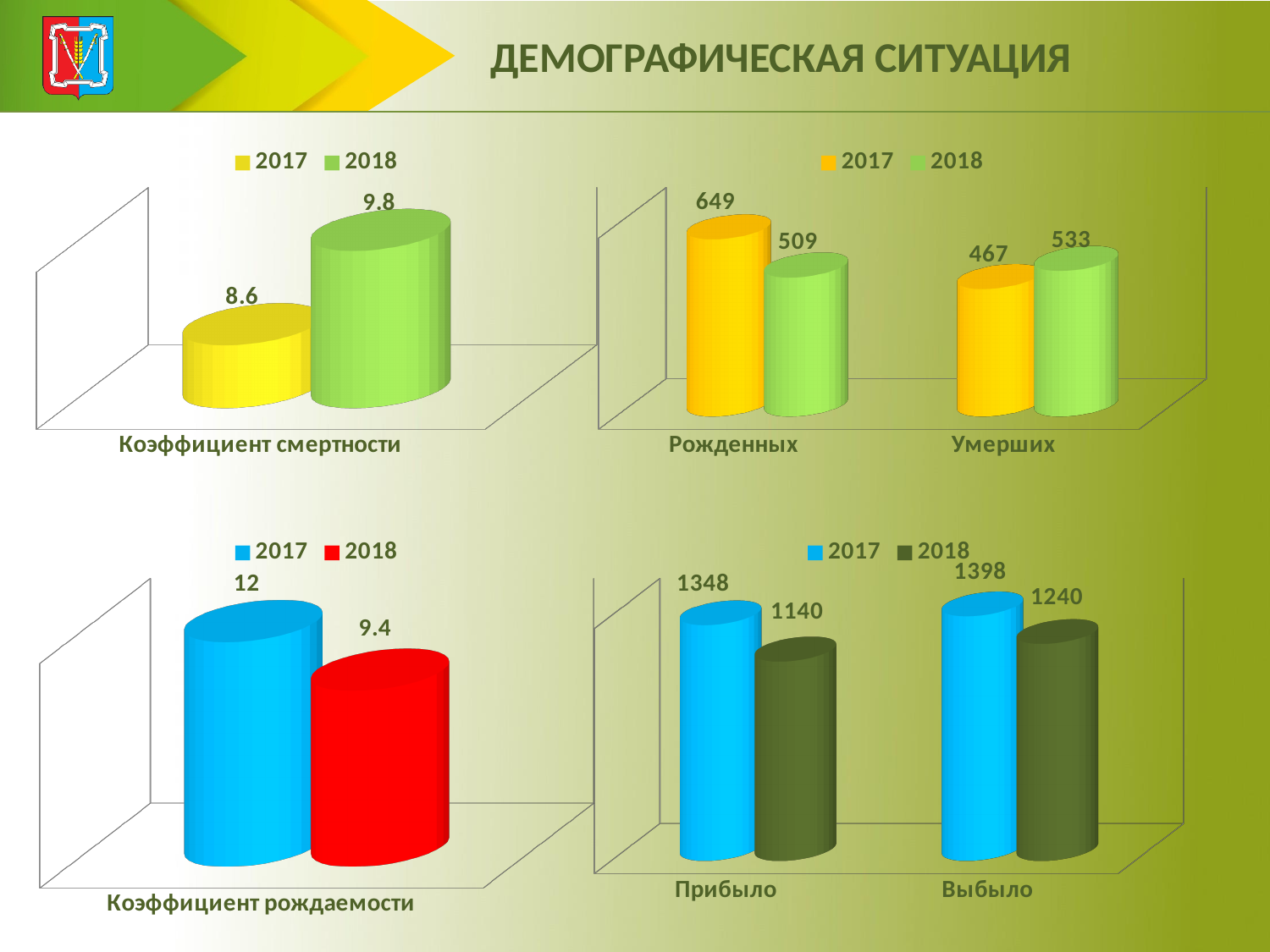
In the bottom-right chart, how many categories are shown on the x axis? 2 In the bottom-right chart, what is the 2018 value for Прибыло? 1140 How many series does the legend of the top-right chart list? 2 In the top-left chart (Коэффициент смертности), what is the value for 2017? 8.6 In the top-right chart, what is the 2017 value for Рожденных? 649 In the bottom-left chart (Коэффициент рождаемости), what is the difference between the 2017 and 2018 values? 2.6 In the bottom-right chart, what is the 2017 value for Выбыло? 1398 In the top-left chart (Коэффициент смертности), what is the value for 2018? 9.8 In the top-right chart, which year has the larger value for Умерших, 2017 or 2018? 2018 In the bottom-left chart (Коэффициент рождаемости), what is the value for 2017? 12 In the top-right chart, what is the 2018 value for Умерших? 533 In the top-right chart, what is the difference between the 2017 and 2018 values for Рожденных? 140